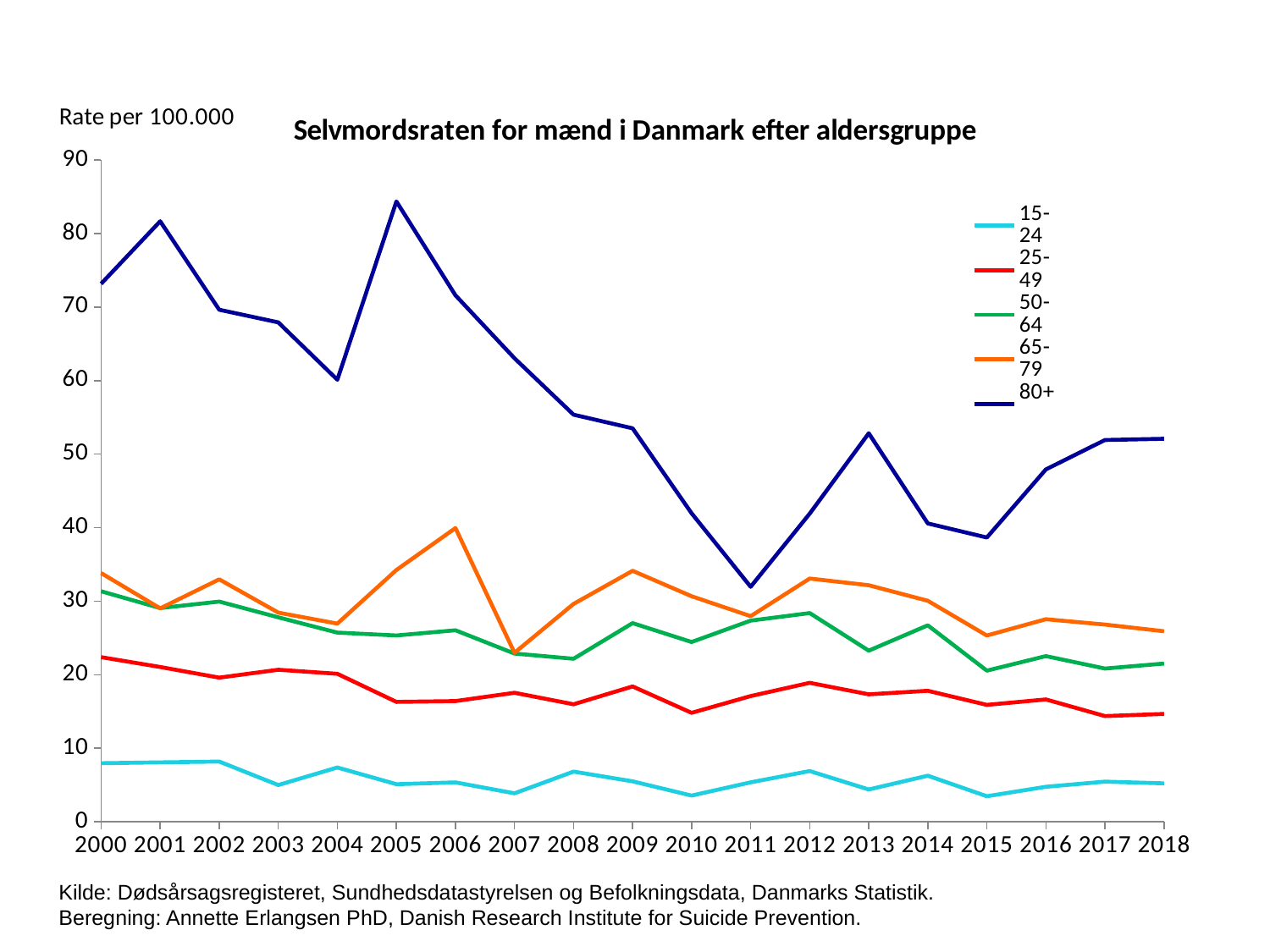
Is the value for the 80+ group in 2000 greater or less than 70? greater Is the value for the 15-24 group in 2003 greater or less than 10? less In 2012, which is larger: the rate for the 65-79 group or the 50-64 group? 65-79 How many age-group series does the legend list? 5 How many years are plotted along the x axis? 19 In which year does the 80+ line reach its lowest value? 2011 Which age group has the highest suicide rate in 2005? 80+ Which age group has the lowest suicide rate in 2010? 15-24 Is the value for the 65-79 group in 2006 greater or less than 35? greater Does the rate for the 25-49 group rise or fall overall from 2000 to 2018? fall What kind of chart is shown on the slide? line chart In which year does the 80+ line reach its highest value? 2005